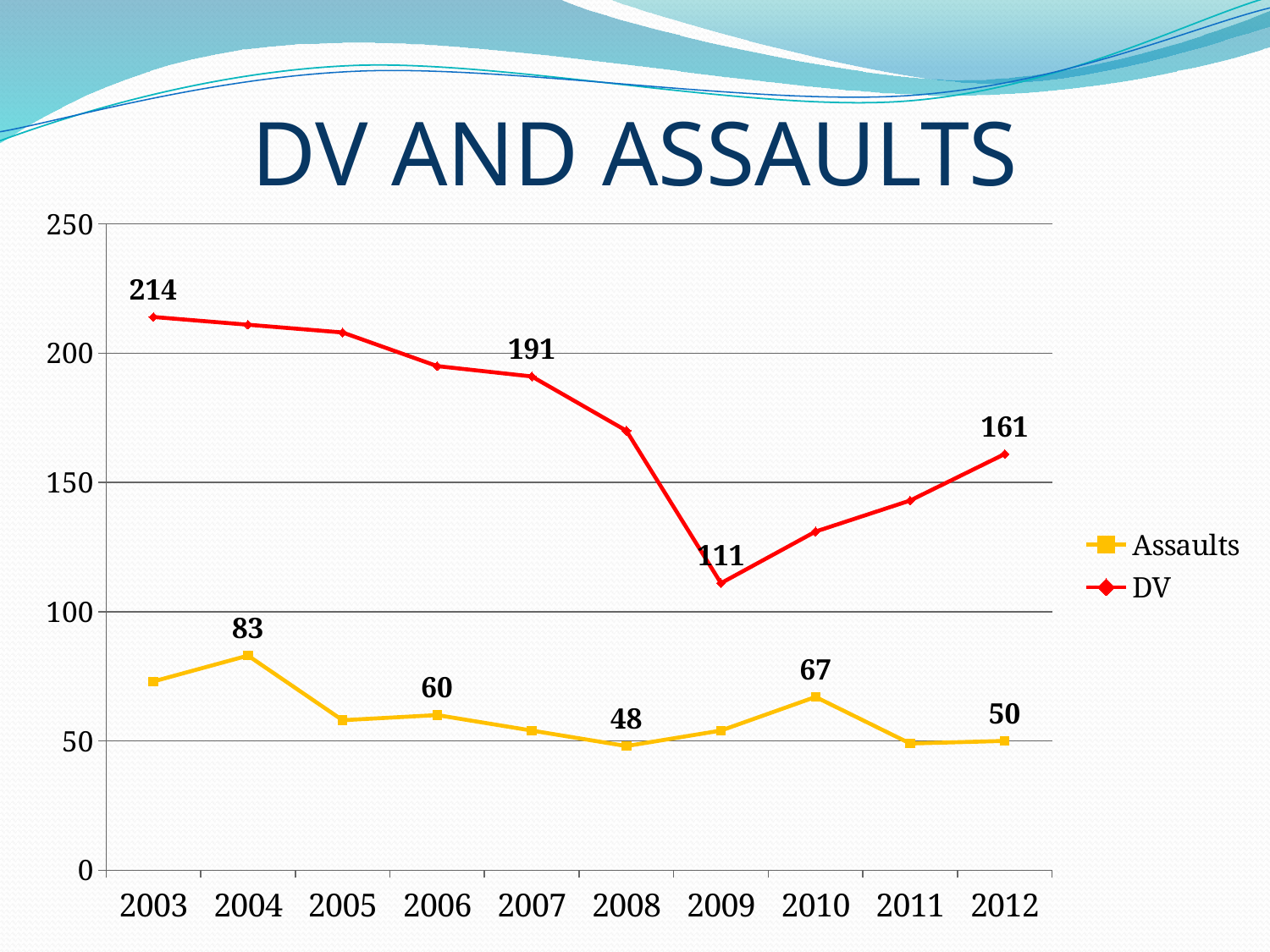
What is the Assaults value for 2008? 48 Is the DV value for 2005 greater or less than 200? greater In which year is the Assaults series at its highest? 2004 What is the difference between the DV value in 2003 and the DV value in 2012? 53 What is the title of the chart? DV AND ASSAULTS In which year is the DV series at its lowest? 2009 How many years are shown on the x axis? 10 What type of chart is shown on the slide? line chart What is the DV value for 2009? 111 What is the Assaults value for 2004? 83 What is the DV value for 2003? 214 How many series does the legend list? 2